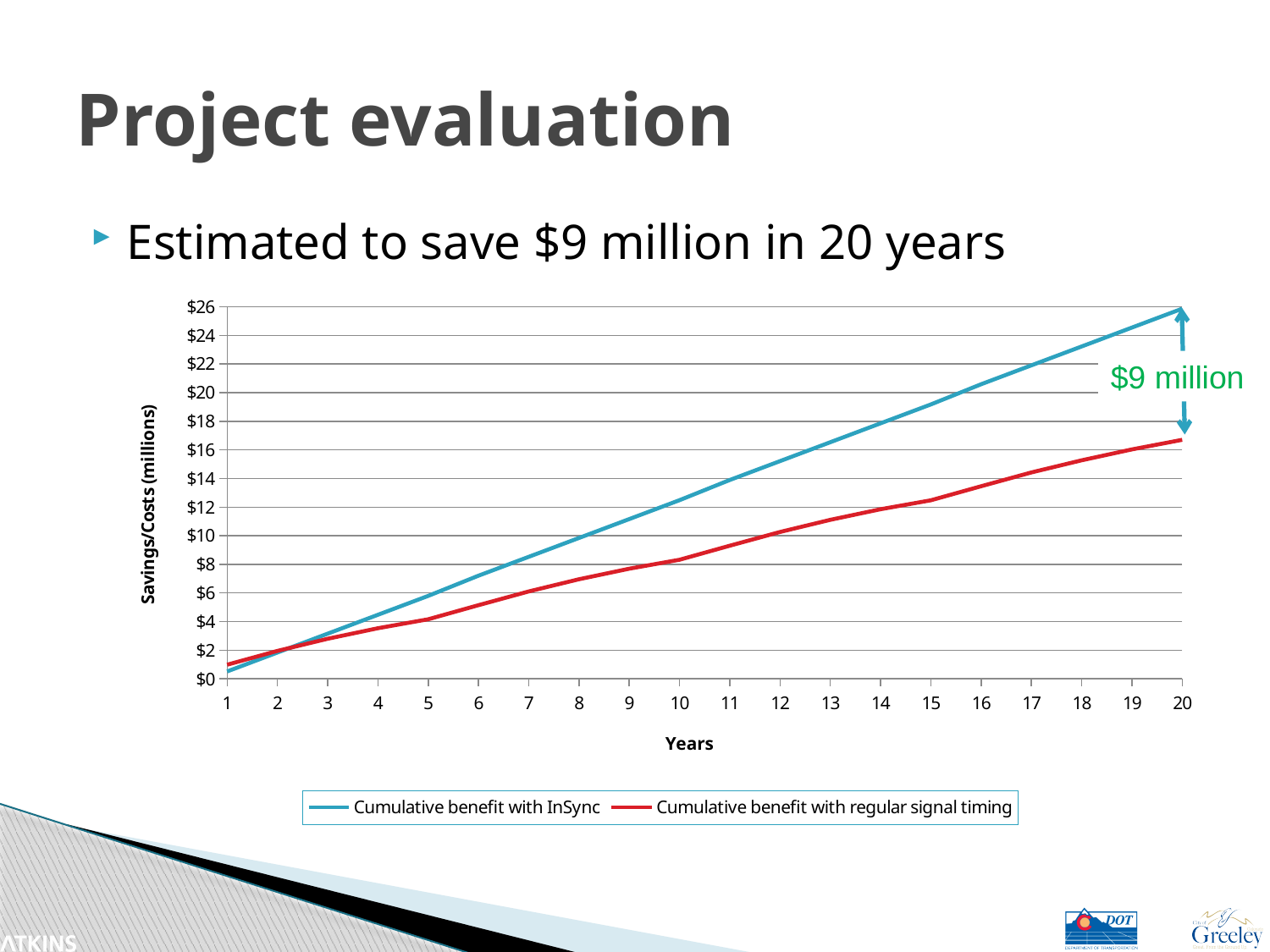
Does the cumulative benefit with InSync rise or fall as the years increase? rise Is the value for cumulative benefit with regular signal timing at year 20 greater or less than $18? less According to the annotation on the chart, what is the difference between the two series at year 20? $9 million At year 1, which series has the higher value: cumulative benefit with InSync or cumulative benefit with regular signal timing? Cumulative benefit with regular signal timing How many series does the chart legend list? 2 What is the title of the vertical axis of the chart? Savings/Costs (millions) Which colour is used for the 'Cumulative benefit with regular signal timing' line? red At year 20, which series has the higher value: cumulative benefit with InSync or cumulative benefit with regular signal timing? Cumulative benefit with InSync How many years are shown along the x axis of the chart? 20 What kind of chart is shown on the slide? line chart Is the value for cumulative benefit with regular signal timing at year 15 greater or less than $14? less Is the value for cumulative benefit with InSync at year 20 greater or less than $24? greater